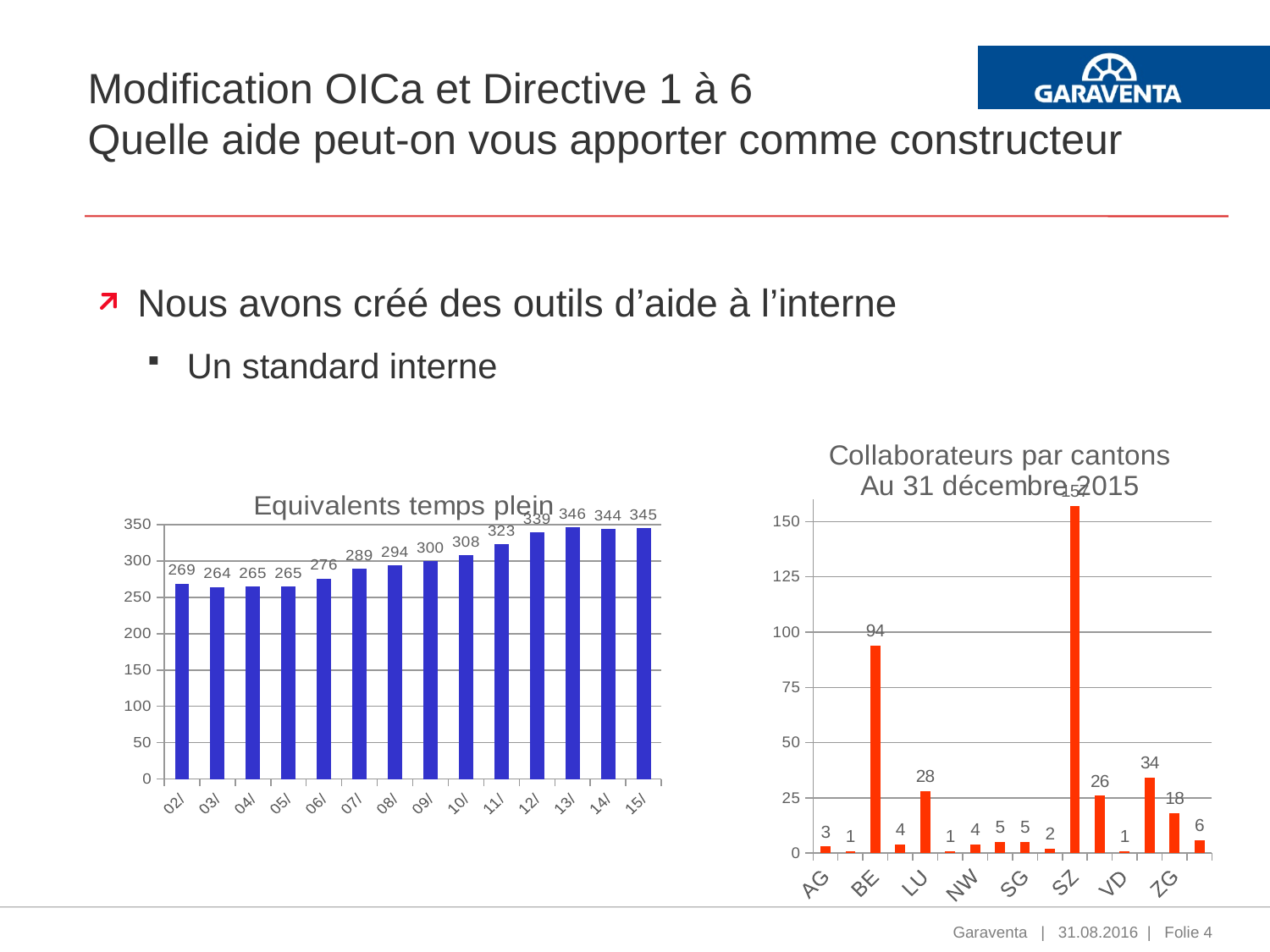
In the 'Collaborateurs par cantons' chart, what is the value for LU? 28 In the 'Collaborateurs par cantons' chart, which canton has the highest value? SZ In the 'Equivalents temps plein' chart, what is the value for 15/? 345 In the 'Collaborateurs par cantons' chart, what is the value for BE? 94 In the 'Equivalents temps plein' chart, do the values generally rise or fall from 02/ to 15/? rise How many bars are shown in the 'Equivalents temps plein' chart? 14 In the 'Equivalents temps plein' chart, which year has the lowest value? 03/ In the 'Equivalents temps plein' chart, which year has the highest value? 13/ In the 'Equivalents temps plein' chart, what is the difference between the values for 15/ and 02/? 76 In the 'Collaborateurs par cantons' chart, is the value for SZ greater or less than 150? greater What kind of chart is the 'Equivalents temps plein' chart on the left? bar chart In the 'Equivalents temps plein' chart, what is the value for 02/? 269